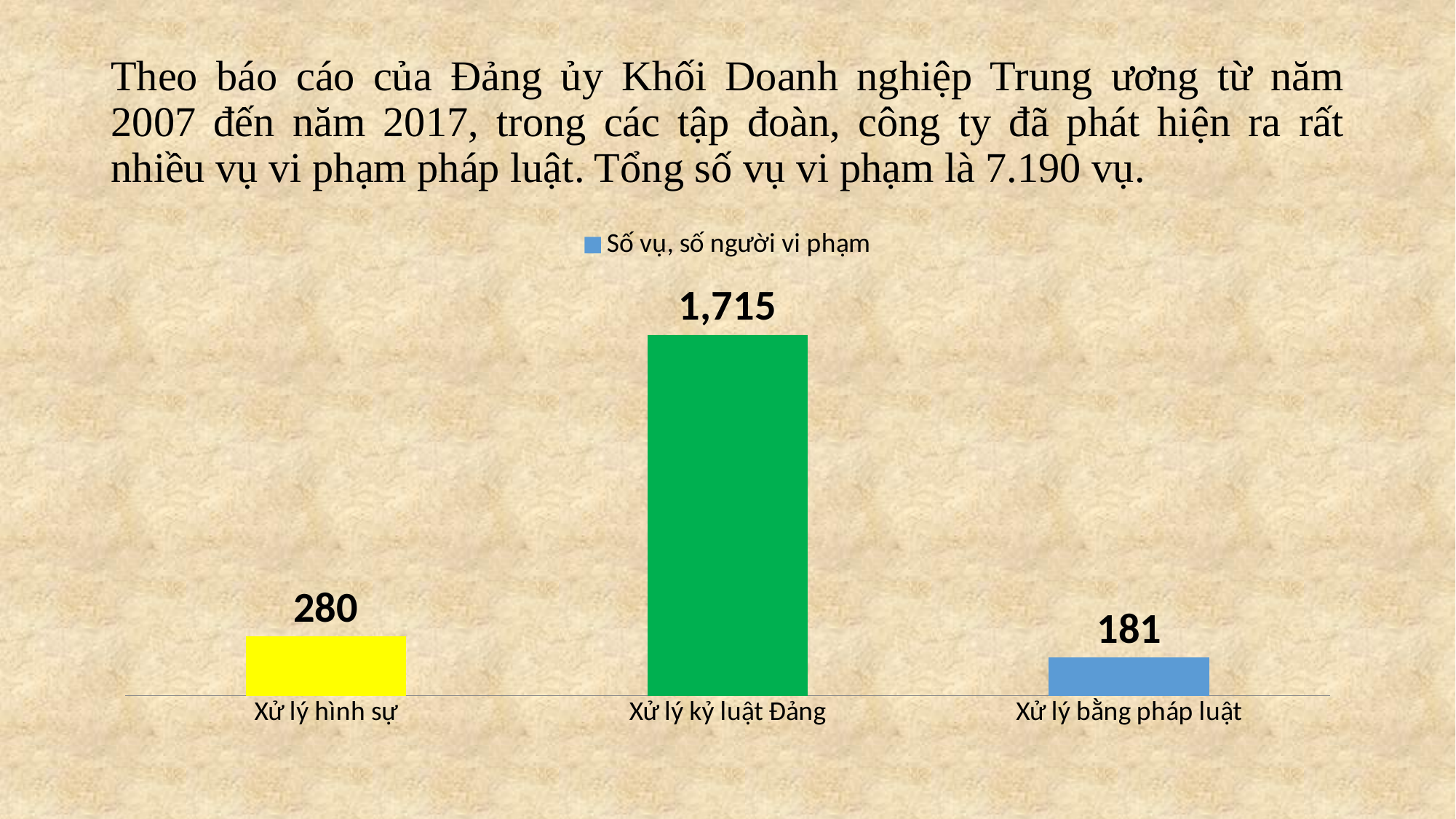
What is the value for Xử lý bằng pháp luật? 181 What is the difference between the values for Xử lý kỷ luật Đảng and Xử lý hình sự? 1,435 How many categories are shown on the x axis? 3 What is the value for Xử lý hình sự? 280 Which category has the highest value? Xử lý kỷ luật Đảng Which is larger, the value for Xử lý hình sự or the value for Xử lý bằng pháp luật? Xử lý hình sự What is the difference between the values for Xử lý hình sự and Xử lý bằng pháp luật? 99 What is the legend entry of the series shown in the chart? Số vụ, số người vi phạm Which category has the lowest value? Xử lý bằng pháp luật What kind of chart is shown on the slide? Bar chart What is the value for Xử lý kỷ luật Đảng? 1,715 How many series does the legend list? 1